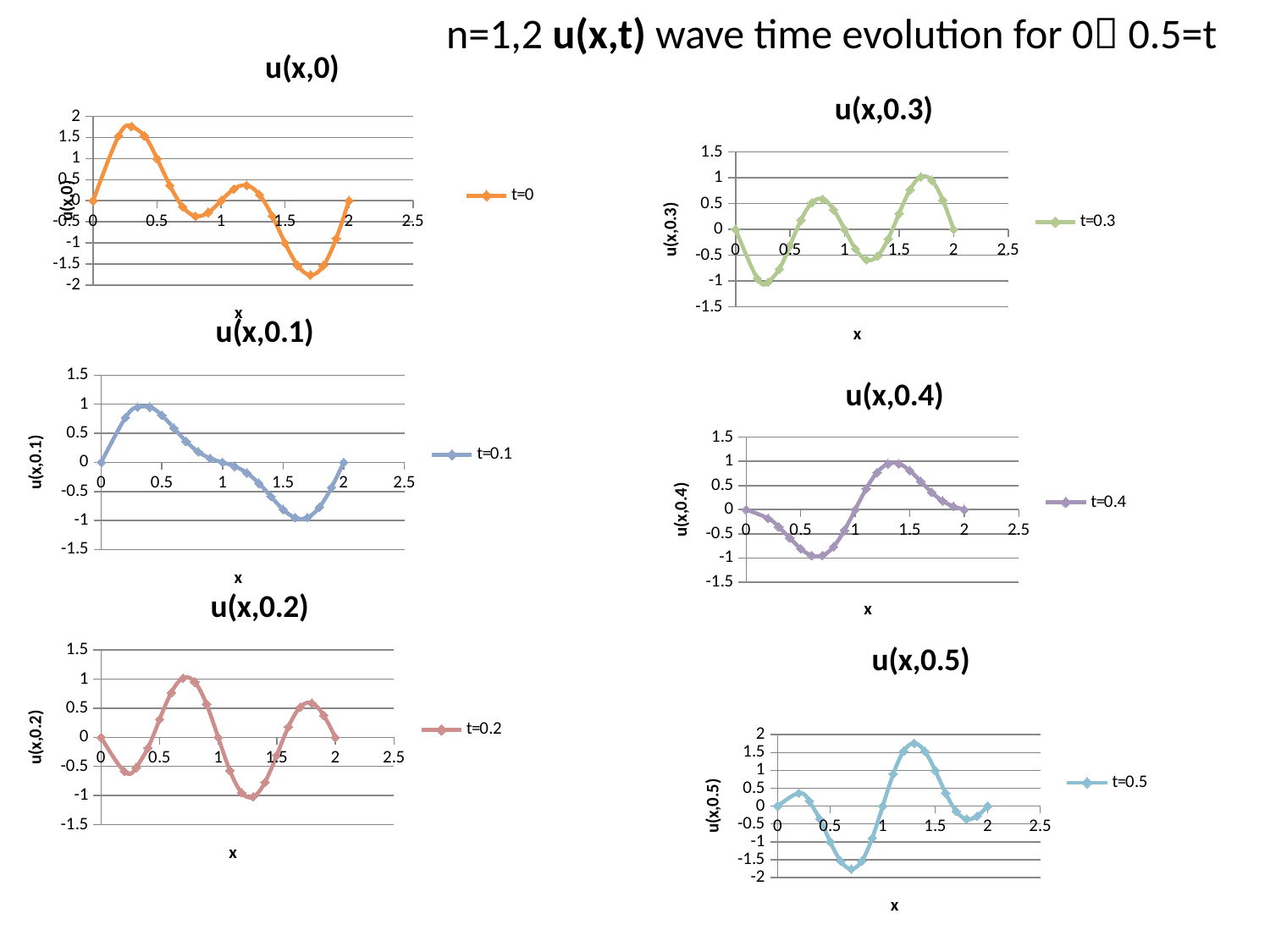
What is the legend entry on the u(x,0.5) chart? t=0.5 What kind of chart is the u(x,0) chart at the top left? line chart What is the title of the chart at the bottom right of the slide? u(x,0.5) How many series does the legend of the u(x,0.3) chart list? 1 On the u(x,0.4) chart, is the value at x=1.4 greater or less than 0.5? greater On the u(x,0.1) chart, is the value at x=1.7 greater or less than -0.5? less How many charts are shown on the slide? 6 On the u(x,0.5) chart, is the lowest value near x=0.7 greater or less than -1.5? less